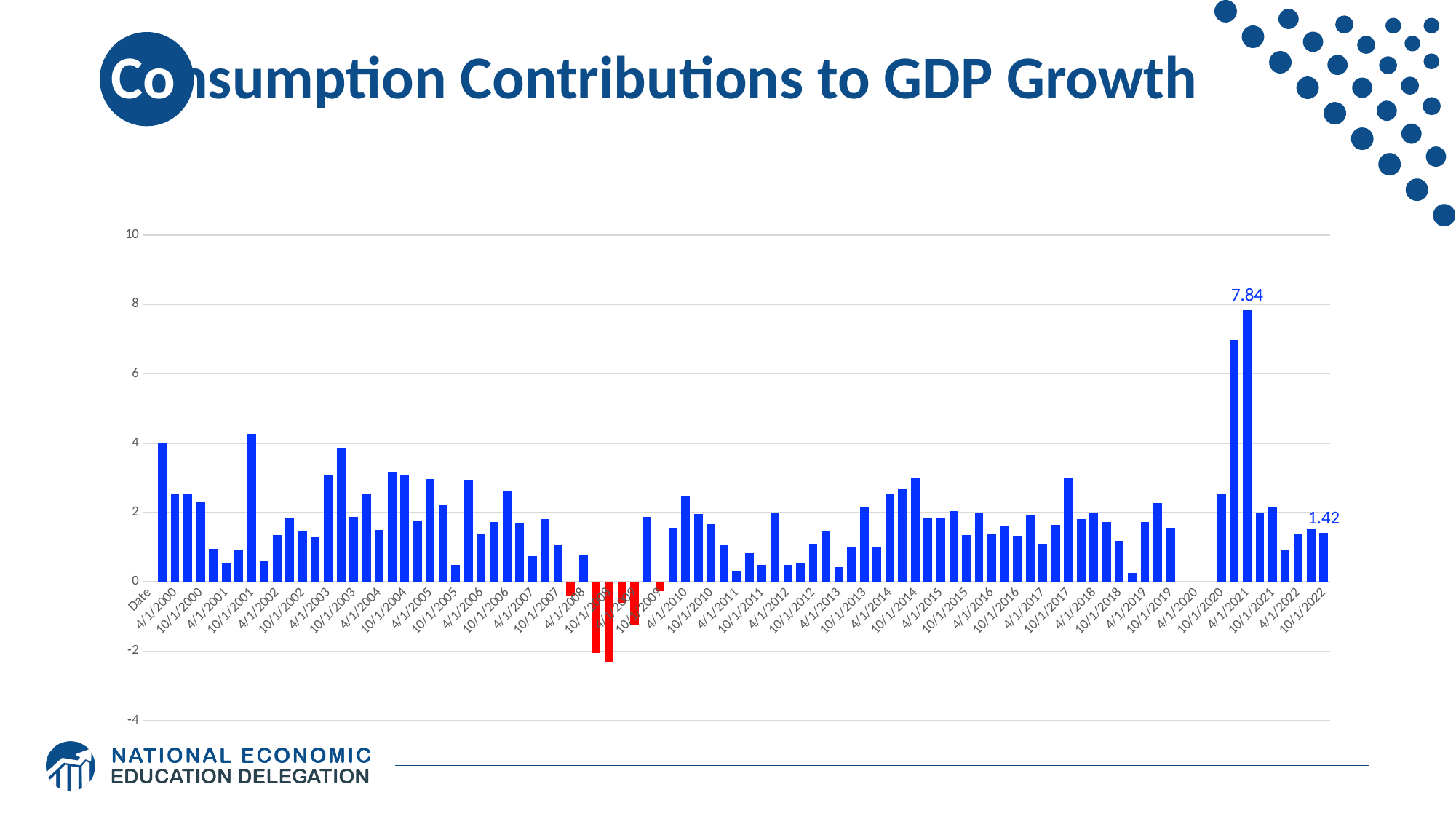
What kind of chart is shown on the slide? bar chart What is the difference between the labelled values 7.84 and 1.42? 6.42 Which is larger, the value for 4/1/2021 or the value for 10/1/2022? 4/1/2021 What is the value labelled on the last bar, for 10/1/2022? 1.42 Is the value for 4/1/2000 greater or less than 2? greater What is the title of the chart? Consumption Contributions to GDP Growth Which date has the highest consumption contribution to GDP growth? 4/1/2021 What colour are the bars with negative values? red Is the value for 4/1/2003 greater or less than 2? greater What is the value of the tallest bar in the chart? 7.84 Is the value for 10/1/2022 greater or less than 2? less What is the highest value shown on the vertical axis? 10